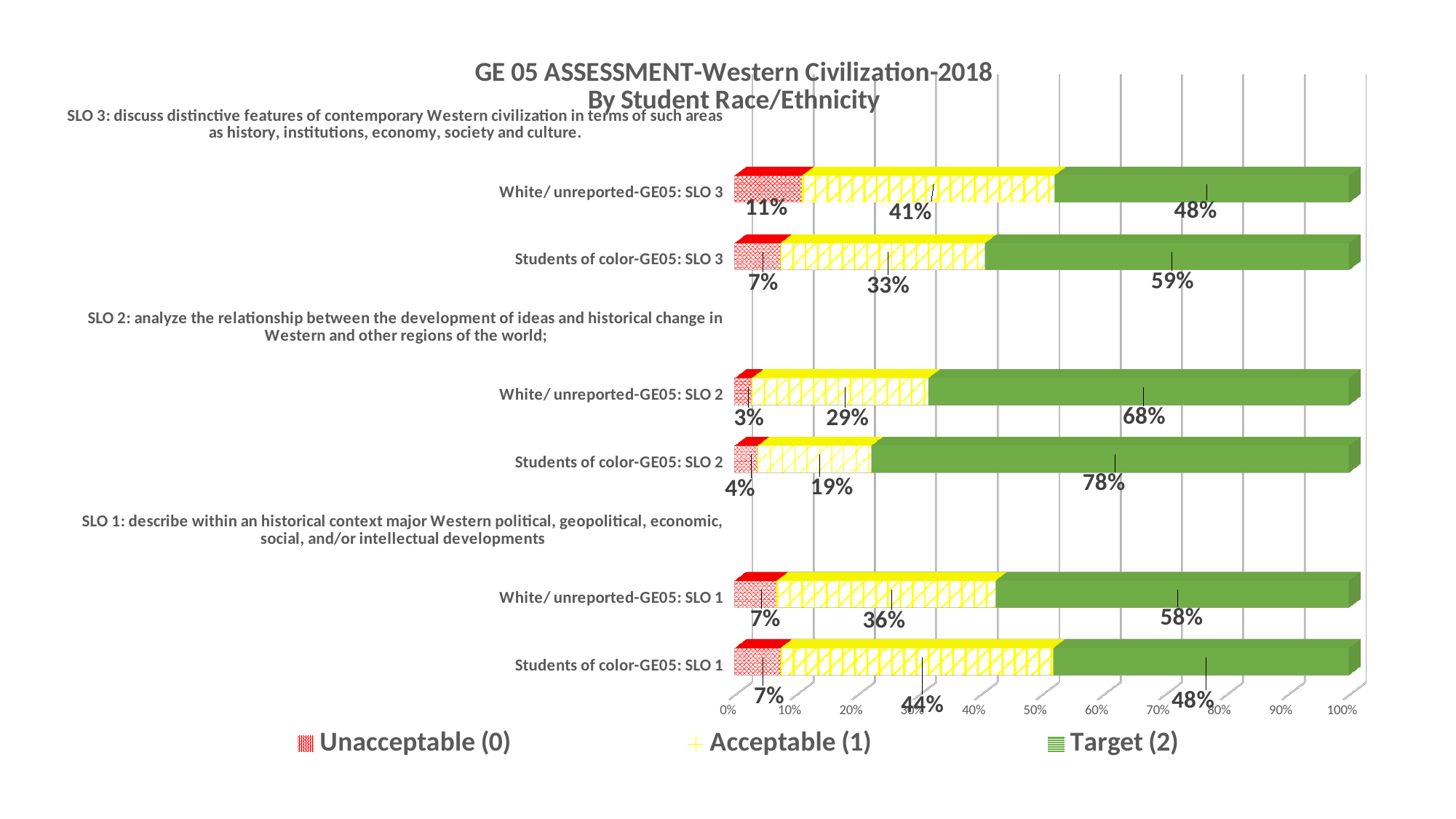
How many stacked bars are plotted on the chart? 6 Which bar has the lowest Acceptable (1) value? Students of color-GE05: SLO 2 What is the difference between the Target (2) values for Students of color-GE05: SLO 3 and White/ unreported-GE05: SLO 3? 11% What kind of chart is shown on the slide? Stacked bar chart What is the Acceptable (1) value for White/ unreported-GE05: SLO 3? 41% Which bar has the highest Target (2) value? Students of color-GE05: SLO 2 Which is larger: the Acceptable (1) value for Students of color-GE05: SLO 1 or for White/ unreported-GE05: SLO 1? Students of color-GE05: SLO 1 What is the Target (2) value for Students of color-GE05: SLO 2? 78% What is the title of the chart? GE 05 ASSESSMENT-Western Civilization-2018 By Student Race/Ethnicity Which bar has the highest Unacceptable (0) value? White/ unreported-GE05: SLO 3 How many series does the legend list? 3 What is the Unacceptable (0) value for White/ unreported-GE05: SLO 2? 3%